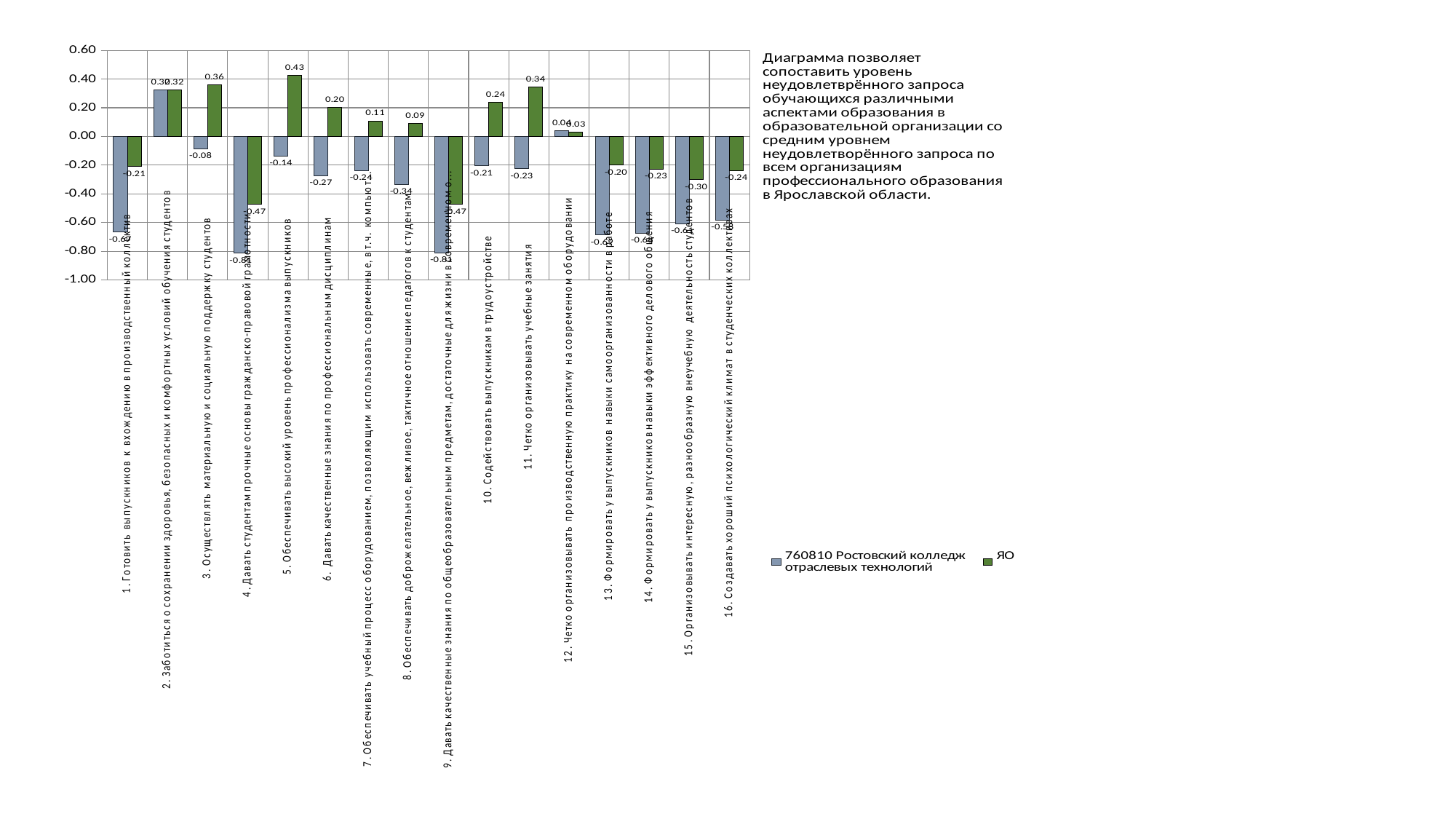
Is the value of the 760810 Ростовский колледж отраслевых технологий series for category 4 greater or less than -0.60? less For which category is the ЯО series value the highest? 5. Обеспечивать высокий уровень профессионализма выпускников What is the value of the 760810 Ростовский колледж отраслевых технологий series for category 3 (Осуществлять материальную и социальную поддержку студентов)? -0.08 How many series does the legend list? 2 What is the value of the ЯО series for category 15 (Организовывать интересную, разнообразную внеучебную деятельность студентов)? -0.30 What is the value of the ЯО series for category 5 (Обеспечивать высокий уровень профессионализма выпускников)? 0.43 How many categories are shown on the x axis of the chart? 16 What is the difference between the ЯО value and the 760810 Ростовский колледж отраслевых технологий value for category 6 (Давать качественные знания по профессиональным дисциплинам)? 0.47 What kind of chart is shown on the slide? Bar chart What is the value of the 760810 Ростовский колледж отраслевых технологий series for category 8 (Обеспечивать доброжелательное, вежливое, тактичное отношение педагогов к студентам)? -0.34 What is the difference between the ЯО value and the 760810 Ростовский колледж отраслевых технологий value for category 5? 0.57 Which is larger for the ЯО series: the value for category 10 or the value for category 11? Category 11